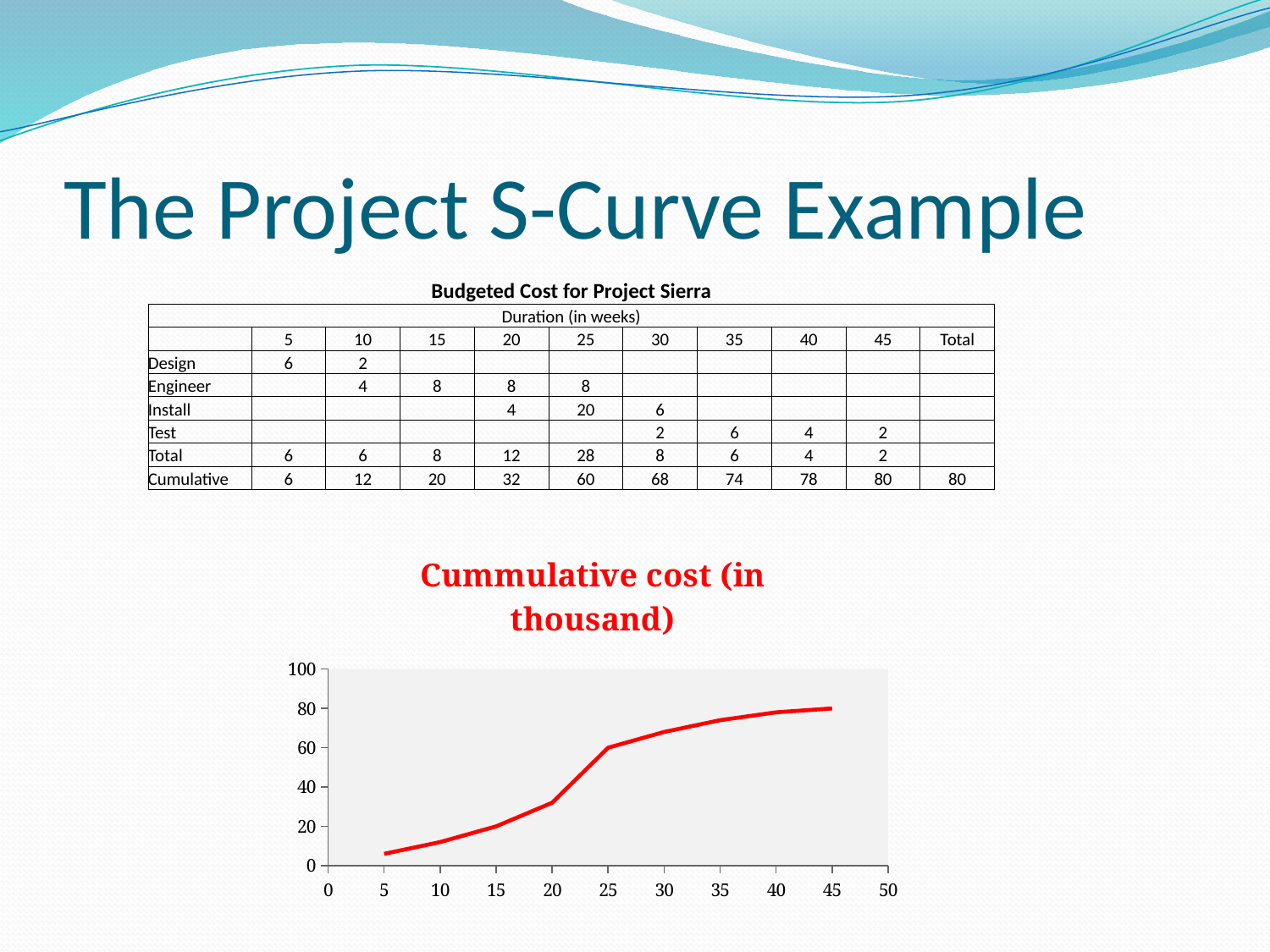
Is the cumulative cost at week 30 greater or less than 60? greater Does the cumulative cost rise or fall as the weeks increase along the x axis? rise What is the cumulative cost at week 15? 20 What kind of chart is shown on the slide? line chart At which week is the cumulative cost highest? 45 At which week is the cumulative cost lowest? 5 What is the title of the chart? Cummulative cost (in thousand) What is the difference between the cumulative cost at week 45 and at week 25? 20 What colour is the line in the chart? red Is the cumulative cost at week 20 greater or less than 40? less What is the cumulative cost at week 45? 80 What is the cumulative cost at week 25? 60